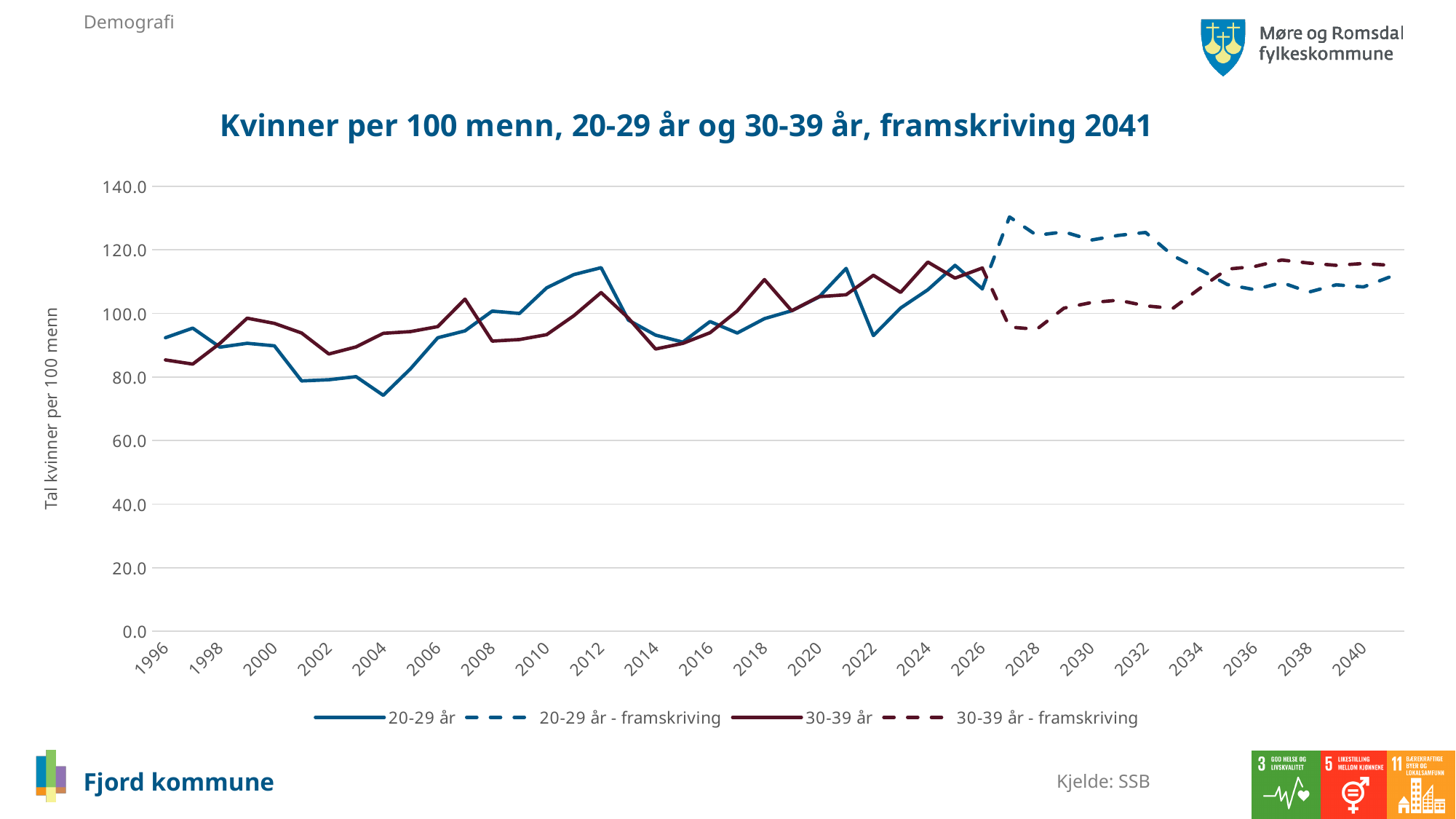
In 2027, which series has the higher value, 20-29 år - framskriving or 30-39 år - framskriving? 20-29 år - framskriving Is the value for 20-29 år - framskriving in 2027 greater or less than 120? greater In 2004, which series has the higher value, 20-29 år or 30-39 år? 30-39 år Is the value for 20-29 år in 2012 greater or less than 100? greater What kind of chart is shown on the slide? line chart How many series does the legend list? 4 What is the label on the vertical axis? Tal kvinner per 100 menn In 2040, which series has the higher value, 20-29 år - framskriving or 30-39 år - framskriving? 30-39 år - framskriving What is the title of the chart? Kvinner per 100 menn, 20-29 år og 30-39 år, framskriving 2041 Is the value for 20-29 år in 2004 greater or less than 80? less Does the 20-29 år line rise or fall between 2004 and 2012? rise